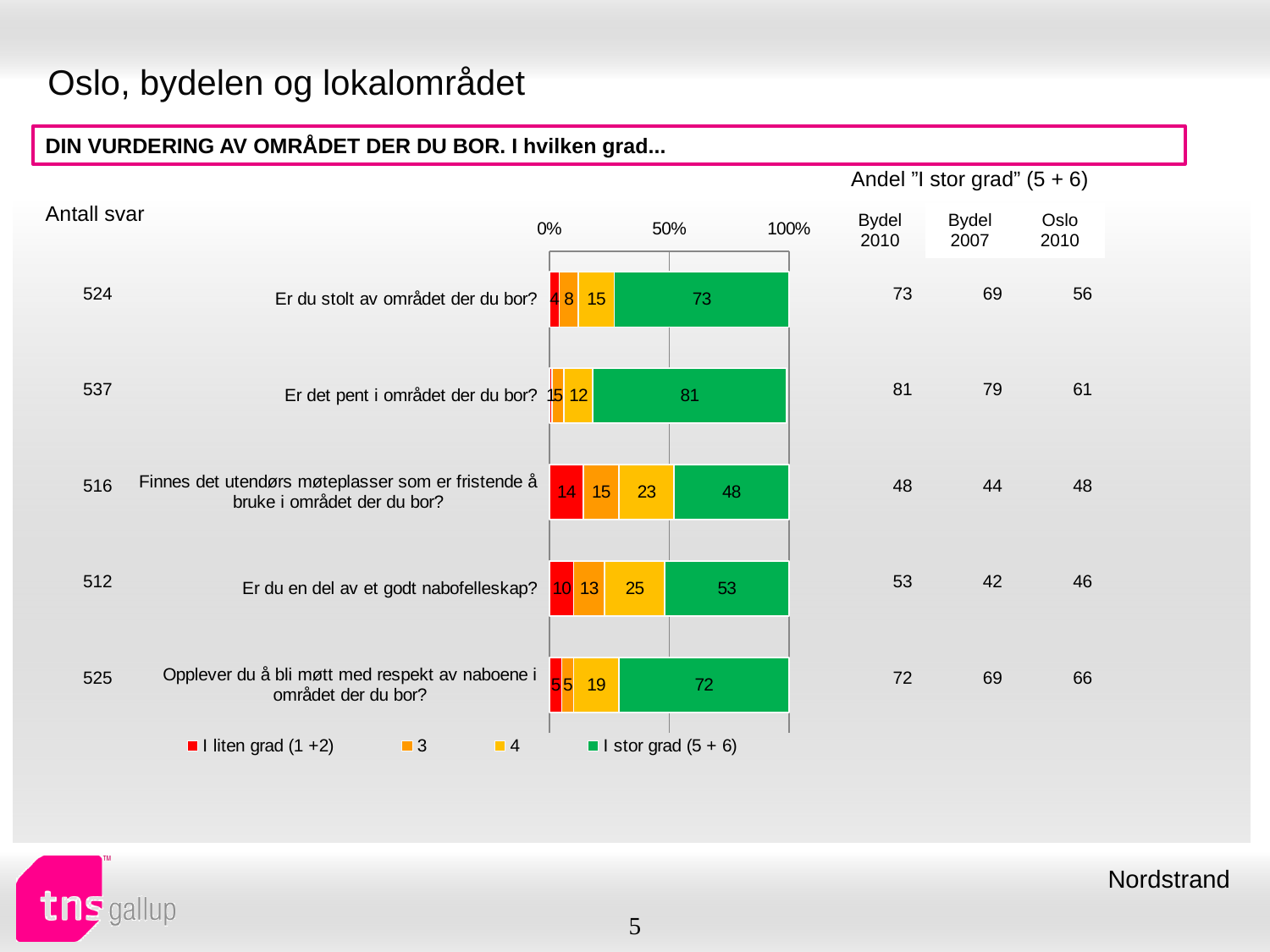
Which category has the highest value for 'I stor grad (5 + 6)'? Er det pent i området der du bor? What kind of chart is shown on the slide? stacked bar chart What is the total of the stacked bar for 'Finnes det utendørs møteplasser som er fristende å bruke i området der du bor?'? 100 What is the value of 'I stor grad (5 + 6)' for 'Er du stolt av området der du bor?'? 73 Which category has the lowest value for 'I stor grad (5 + 6)'? Finnes det utendørs møteplasser som er fristende å bruke i området der du bor? What is the value of 'I liten grad (1 +2)' for 'Finnes det utendørs møteplasser som er fristende å bruke i området der du bor?'? 14 What is the difference between the 'I stor grad (5 + 6)' values for 'Er det pent i området der du bor?' and 'Er du en del av et godt nabofelleskap?'? 28 How many question categories are plotted in the chart? 5 Which is larger: the 'I stor grad (5 + 6)' value for 'Er du stolt av området der du bor?' or for 'Opplever du å bli møtt med respekt av naboene i området der du bor?'? Er du stolt av området der du bor? What is the value of 'I stor grad (5 + 6)' for 'Er det pent i området der du bor?'? 81 What is the value of series '4' for 'Er du en del av et godt nabofelleskap?'? 25 How many series does the chart legend list? 4